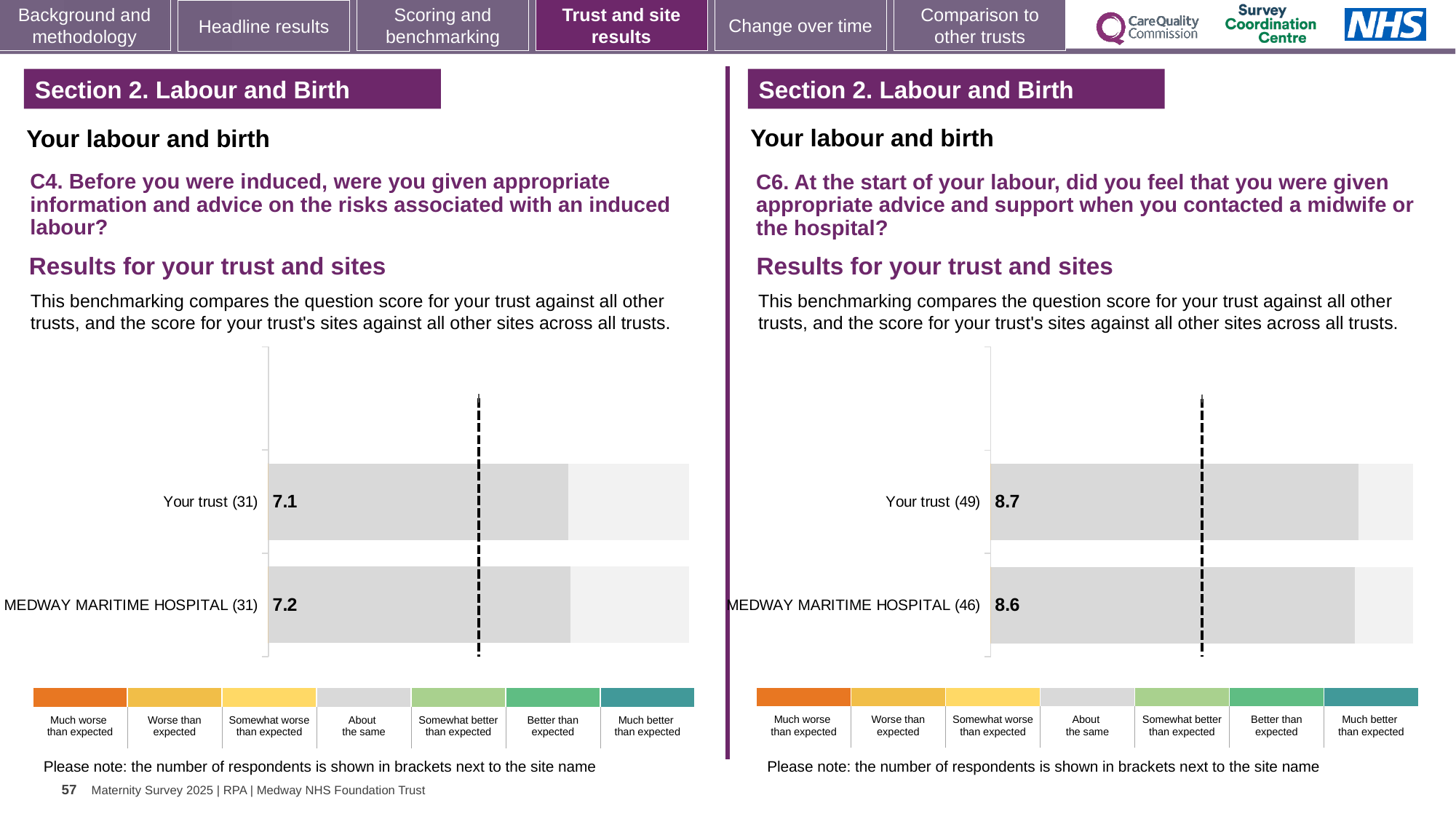
On the left chart (C4), what is the score for Your trust? 7.1 On the left chart (C4), what is the score for MEDWAY MARITIME HOSPITAL? 7.2 On the right chart (C6), which has the higher score, Your trust or MEDWAY MARITIME HOSPITAL? Your trust On the right chart (C6), what is the difference between the Your trust score and the MEDWAY MARITIME HOSPITAL score? 0.1 On the right chart (C6), what is the score for MEDWAY MARITIME HOSPITAL? 8.6 On the left chart (C4), which has the higher score, Your trust or MEDWAY MARITIME HOSPITAL? MEDWAY MARITIME HOSPITAL On the left chart (C4), what is the difference between the MEDWAY MARITIME HOSPITAL score and the Your trust score? 0.1 On the right chart (C6), how many respondents are shown in brackets for Your trust? 49 How many bars are plotted on the left chart (C4)? 2 What type of chart is used on the right side of the slide (C6)? Bar chart On the left chart (C4), how many respondents are shown in brackets for MEDWAY MARITIME HOSPITAL? 31 On the right chart (C6), what is the score for Your trust? 8.7